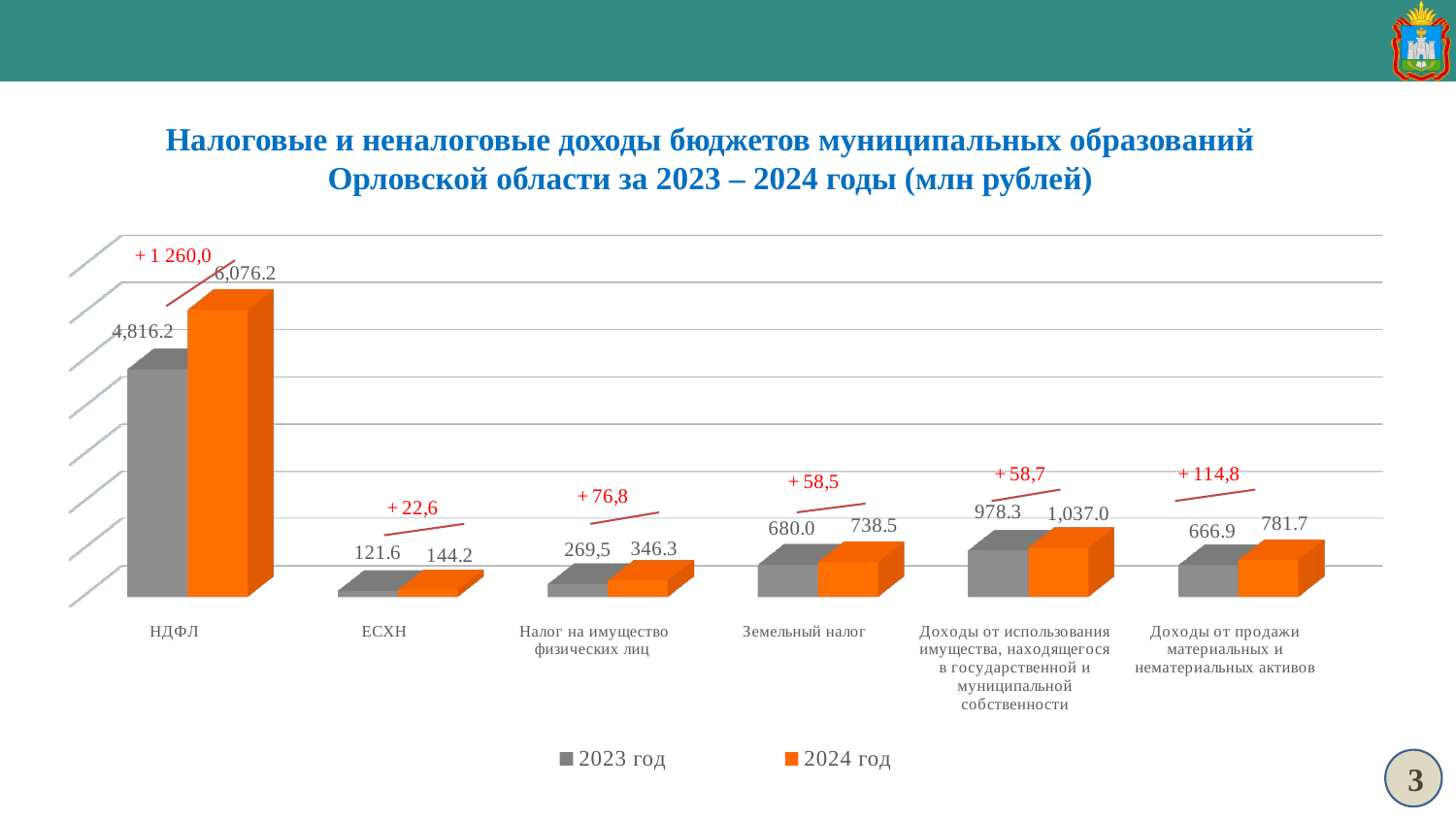
What is the difference between the 2024 год and 2023 год values for Земельный налог? 58.5 What is the value for ЕСХН in 2024 год? 144.2 What is the value for НДФЛ in 2024 год? 6,076.2 Which category has the lowest value in 2024 год? ЕСХН What kind of chart is shown on the slide? bar chart How many categories are shown on the x axis? 6 Which is larger: the 2024 год value for Земельный налог or the 2024 год value for Доходы от продажи материальных и нематериальных активов? 2024 год value for Доходы от продажи материальных и нематериальных активов Which category has the highest value in 2023 год? НДФЛ How many series does the legend list? 2 What increase is annotated in red above the НДФЛ bars? + 1 260,0 What is the 2023 год value for Доходы от продажи материальных и нематериальных активов? 666.9 What is the value for Земельный налог in 2023 год? 680.0